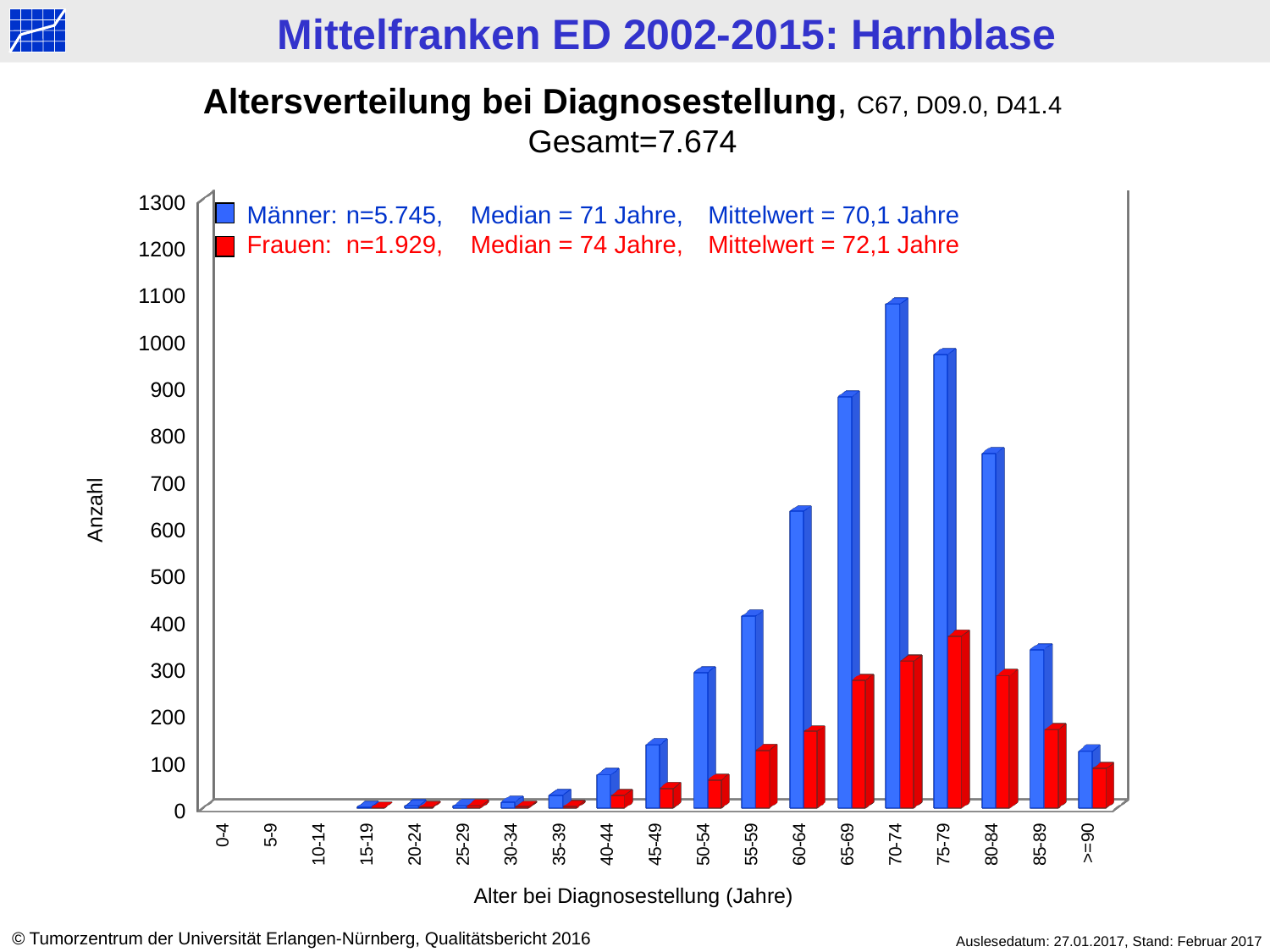
Is the value for Männer in the 70-74 category greater or less than 1000? greater Which age category has the highest value for Frauen? 75-79 According to the legend, what is the median age for Frauen? 74 Jahre How many age categories are shown on the x axis? 19 How many series does the legend list? 2 What kind of chart is shown on the slide? bar chart Is the value for Männer in the >=90 category greater or less than 100? greater Which age category has the highest value for Männer? 70-74 In the 70-74 category, which series has the larger value, Männer or Frauen? Männer Do the Männer values rise or fall from the 70-74 category to the >=90 category? fall Is the value for Männer in the 60-64 category greater or less than 600? greater